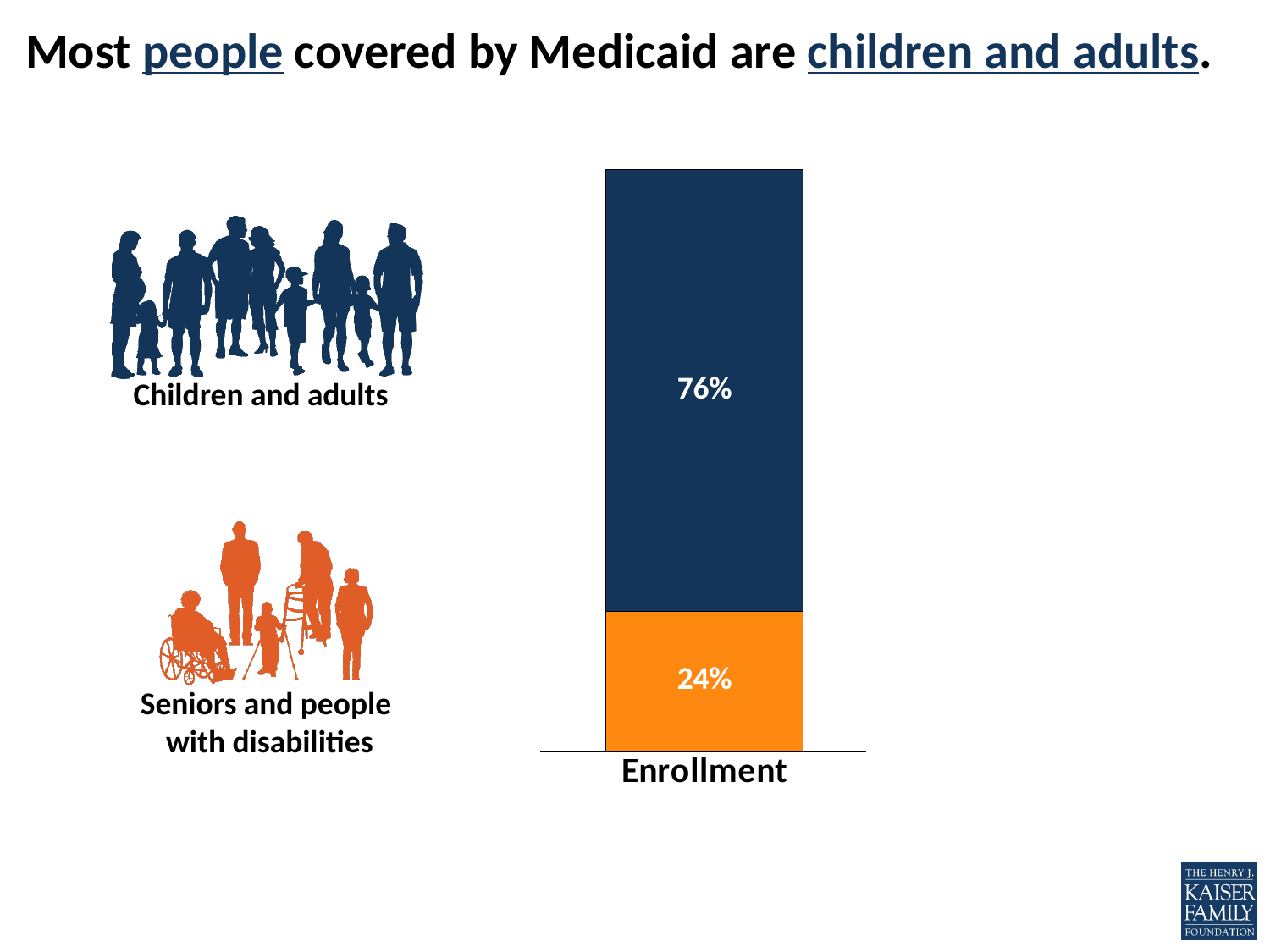
What share of Medicaid enrollment is seniors and people with disabilities? 24% Which colour represents seniors and people with disabilities in the bar? Orange What share of Medicaid enrollment is children and adults? 76% What is the total of the two segments in the Enrollment bar? 100% What kind of chart is shown on the slide? Stacked bar chart Which group has the smallest share of enrollment? Seniors and people with disabilities What is the label on the x axis under the bar? Enrollment What is the difference in percentage points between the children and adults share and the seniors and people with disabilities share of enrollment? 52 Which group makes up the larger share of enrollment, children and adults or seniors and people with disabilities? Children and adults How many groups are shown in the Enrollment bar? 2